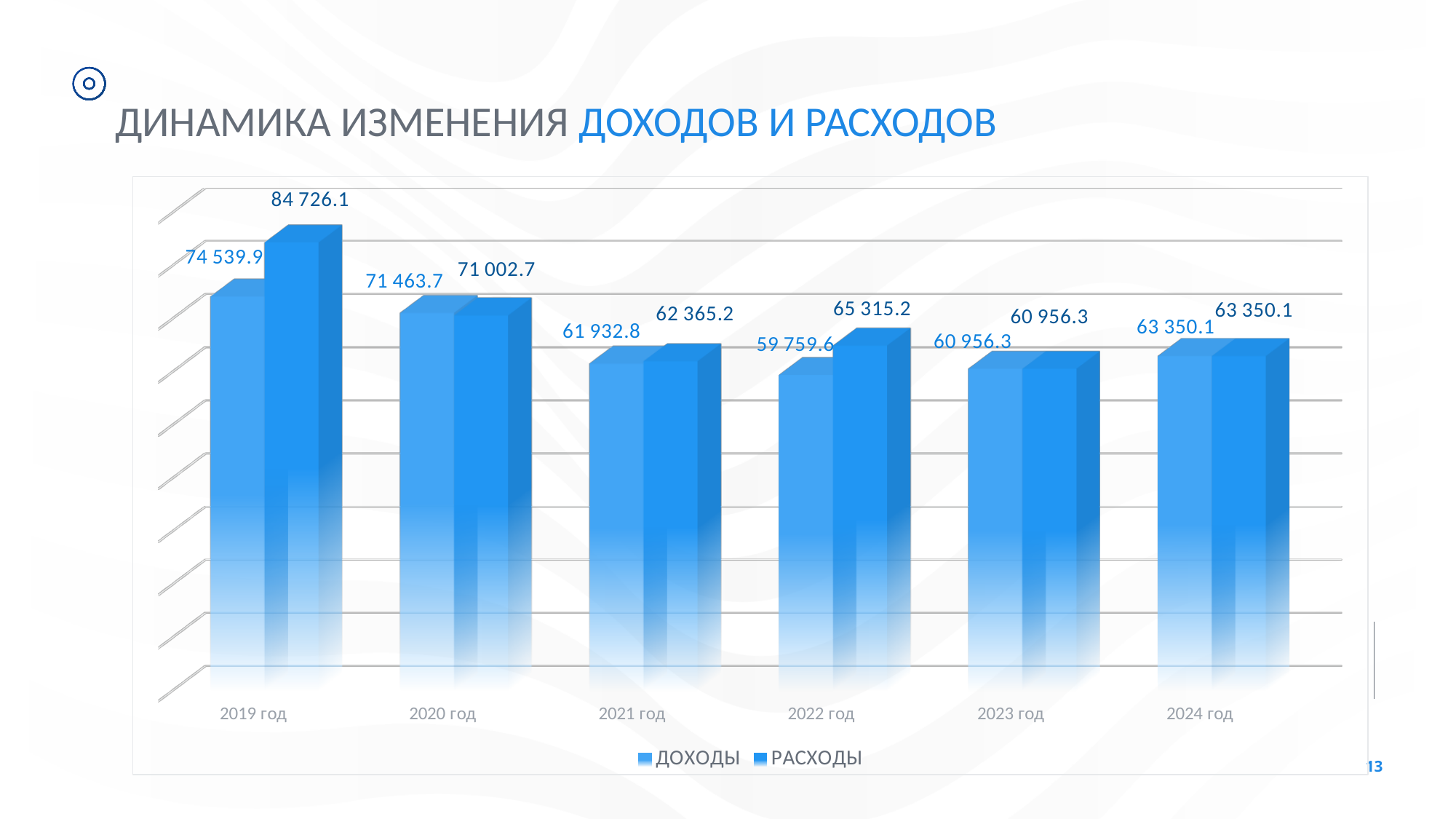
What is the value of ДОХОДЫ for 2019 год? 74 539.9 What is the value of ДОХОДЫ for 2024 год? 63 350.1 What is the difference between РАСХОДЫ and ДОХОДЫ in 2022 год? 5 555.6 Which is larger in 2020 год, ДОХОДЫ or РАСХОДЫ? ДОХОДЫ In which year is РАСХОДЫ the highest? 2019 год Does ДОХОДЫ rise or fall from 2019 год to 2022 год? Fall What is the value of РАСХОДЫ for 2022 год? 65 315.2 In which year is ДОХОДЫ the lowest? 2022 год How many series does the legend list? 2 How many years are shown on the x axis? 6 What kind of chart is shown on the slide? Bar chart What is the difference between РАСХОДЫ and ДОХОДЫ in 2019 год? 10 186.2